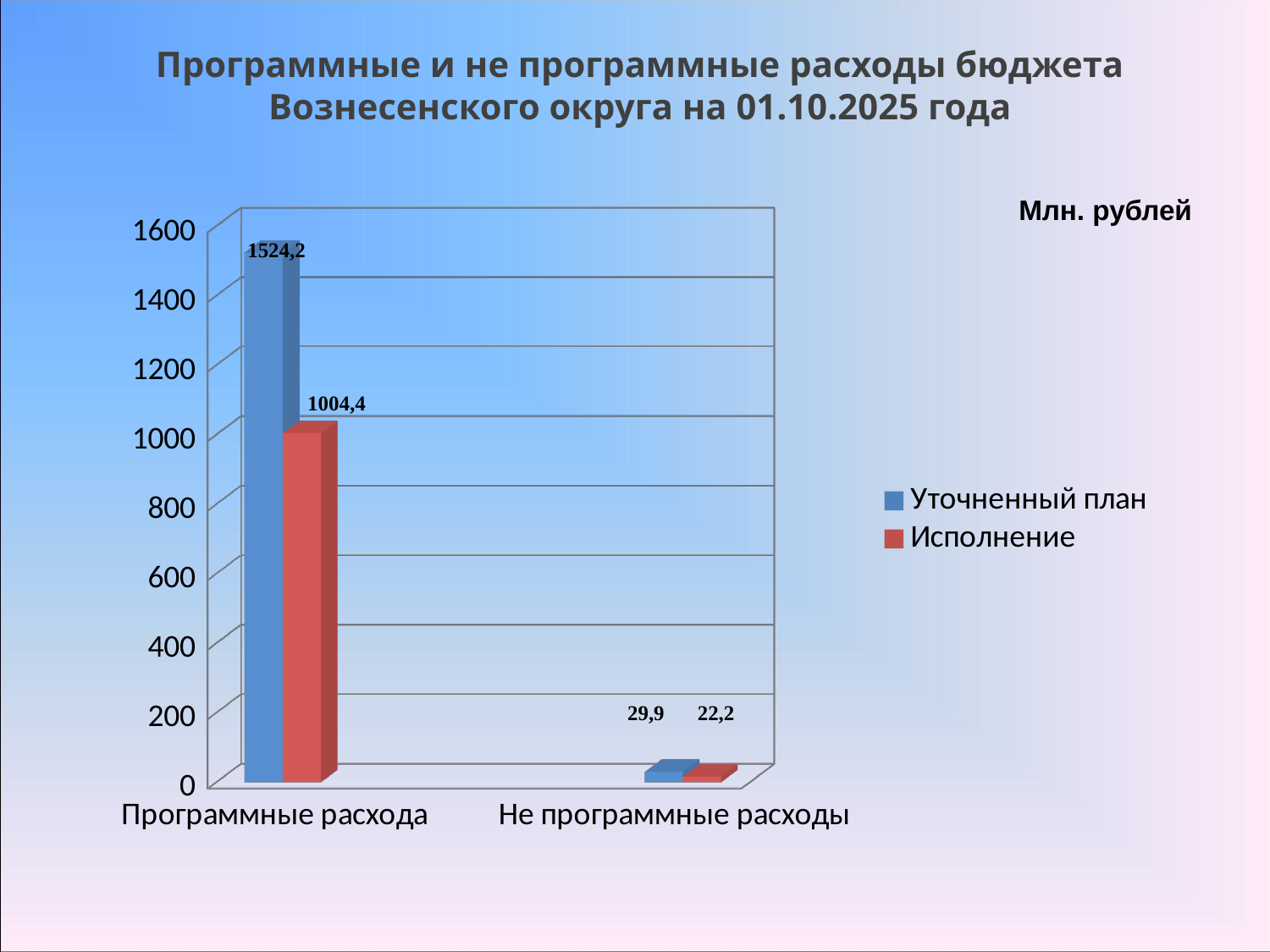
How many series does the legend list? 2 What is the value of "Уточненный план" for "Программные расхода"? 1524,2 Which category has the highest "Уточненный план" value? Программные расхода What is the difference between "Уточненный план" and "Исполнение" for "Не программные расходы"? 7,7 What is the difference between "Уточненный план" and "Исполнение" for "Программные расхода"? 519,8 How many categories are shown on the x axis? 2 What type of chart is shown on the slide? Bar chart Which category has the lowest "Исполнение" value? Не программные расходы What is the value of "Исполнение" for "Не программные расходы"? 22,2 Which is larger for "Не программные расходы": "Уточненный план" or "Исполнение"? Уточненный план What is the value of "Уточненный план" for "Не программные расходы"? 29,9 What is the value of "Исполнение" for "Программные расхода"? 1004,4